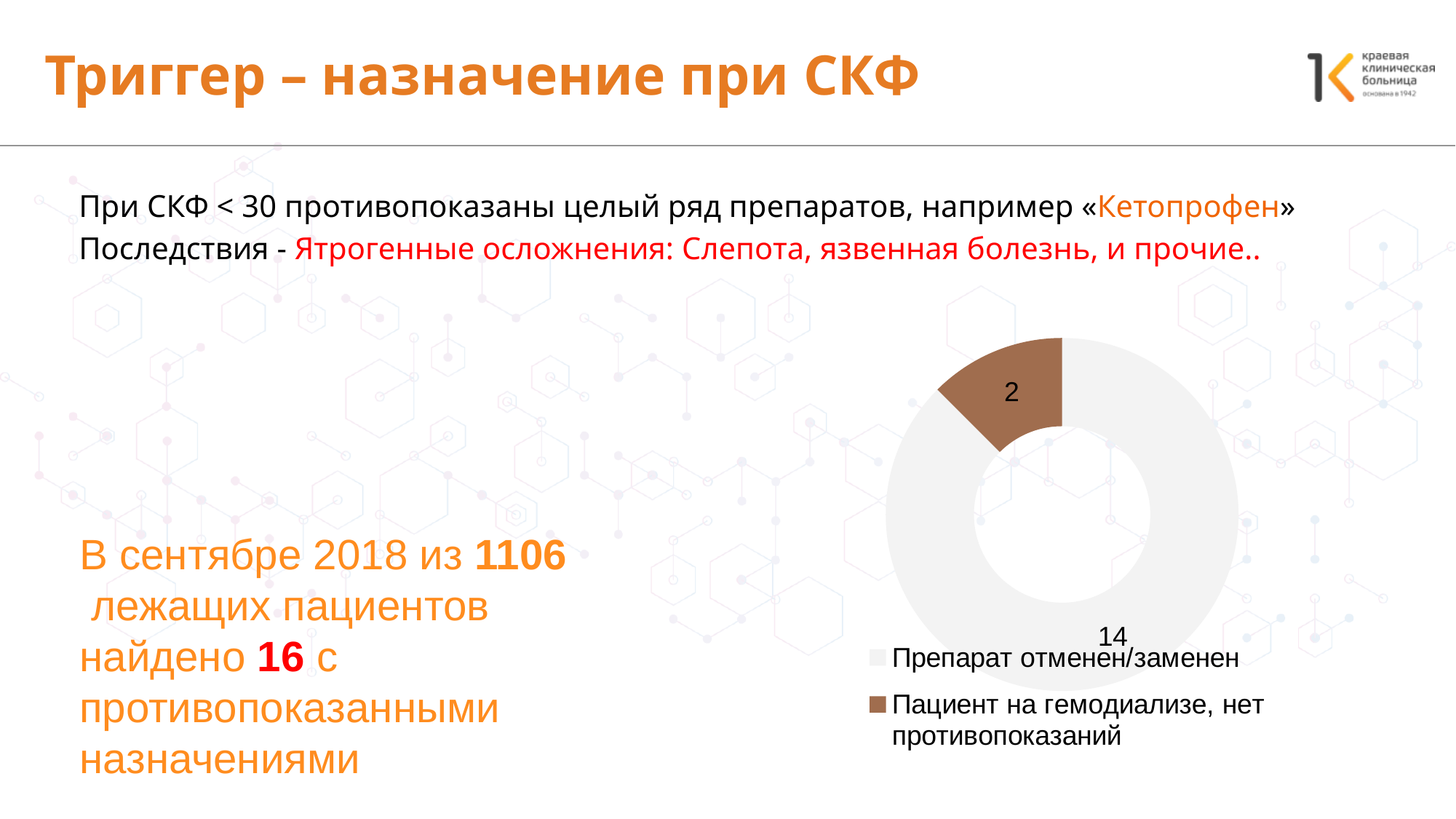
What type of chart is shown on the slide? Doughnut (pie) chart What colour is the slice for "Пациент на гемодиализе, нет противопоказаний"? Brown How many categories does the chart show? 2 Which is larger: "Препарат отменен/заменен" or "Пациент на гемодиализе, нет противопоказаний"? Препарат отменен/заменен What is the total of all slices in the chart? 16 What is the value for "Препарат отменен/заменен"? 14 Which category has the largest slice? Препарат отменен/заменен What share of the chart does "Пациент на гемодиализе, нет противопоказаний" represent? 12.5% What is the value for "Пациент на гемодиализе, нет противопоказаний"? 2 What is the difference between the values for "Препарат отменен/заменен" and "Пациент на гемодиализе, нет противопоказаний"? 12 Which category has the smallest slice? Пациент на гемодиализе, нет противопоказаний What share of the chart does "Препарат отменен/заменен" represent? 87.5%